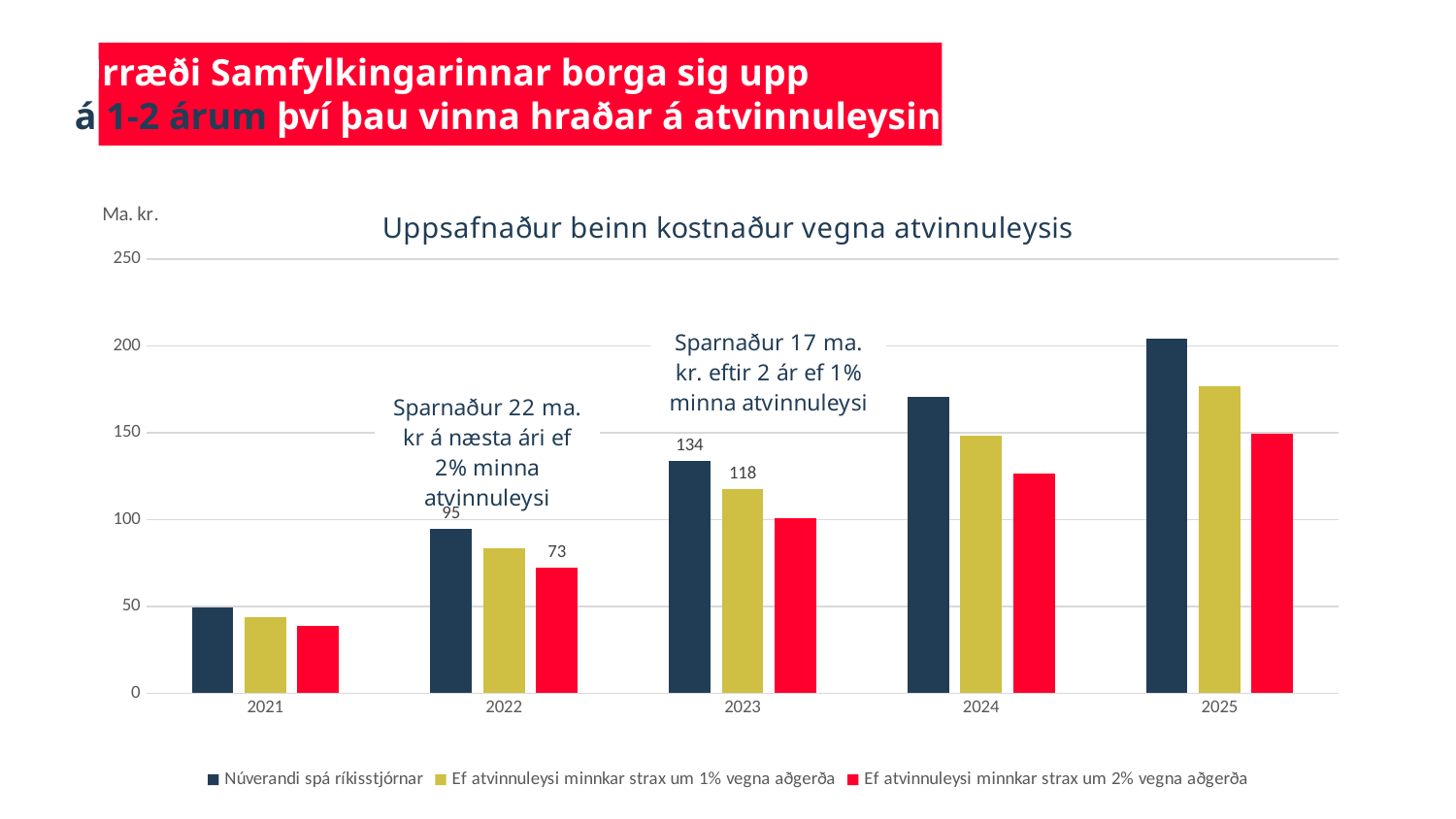
Do the Núverandi spá ríkisstjórnar values rise or fall from 2021 to 2025? rise How many series does the legend list? 3 What is the value for Núverandi spá ríkisstjórnar in 2023? 134 What is the value for 'Ef atvinnuleysi minnkar strax um 1% vegna aðgerða' in 2023? 118 In which year is the Núverandi spá ríkisstjórnar bar highest? 2025 What is the difference between the Núverandi spá ríkisstjórnar value and the 2% scenario value in 2022? 22 What is the value for 'Ef atvinnuleysi minnkar strax um 2% vegna aðgerða' in 2022? 73 What is the value for Núverandi spá ríkisstjórnar in 2022? 95 Is the value for 'Ef atvinnuleysi minnkar strax um 2% vegna aðgerða' in 2024 greater or less than 100? greater What is the difference between the Núverandi spá ríkisstjórnar value and the 1% scenario value in 2023? 17 How many years are shown on the x axis? 5 Is the value for Núverandi spá ríkisstjórnar in 2024 greater or less than 150? greater